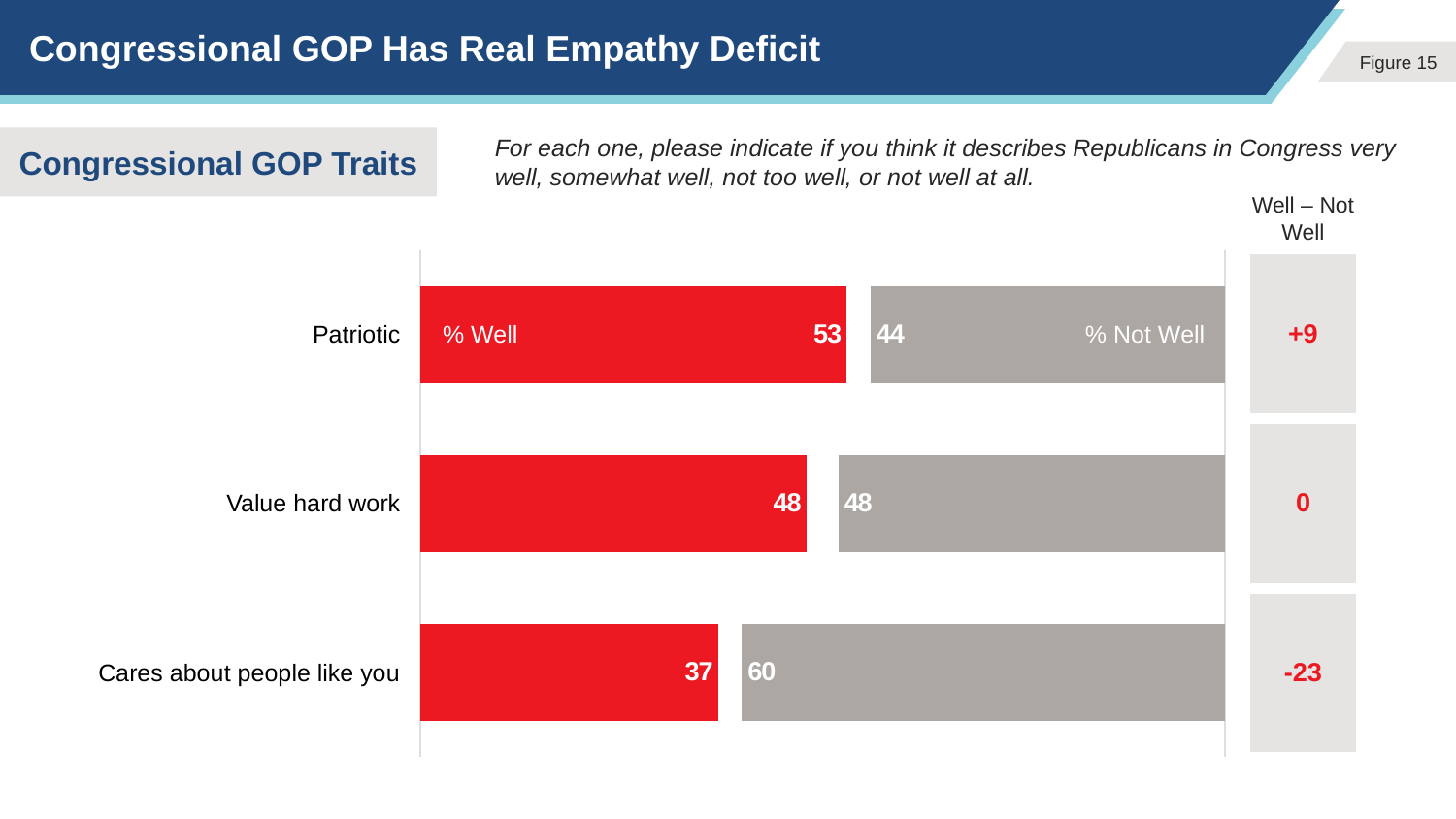
Which trait has the highest % Not Well value? Cares about people like you Which trait has the highest % Well value? Patriotic What kind of chart is shown on the slide? Bar chart What is the % Well value for "Value hard work"? 48 What is the % Not Well value for "Cares about people like you"? 60 How many series does the chart show? 2 Which trait has the lowest % Well value? Cares about people like you How many traits are shown in the chart? 3 What is the difference between % Not Well and % Well for "Cares about people like you"? 23 What percentage say "Patriotic" describes Republicans in Congress well? 53 What is the Well – Not Well value shown for "Patriotic"? +9 Is the % Well value larger for "Patriotic" or for "Cares about people like you"? Patriotic